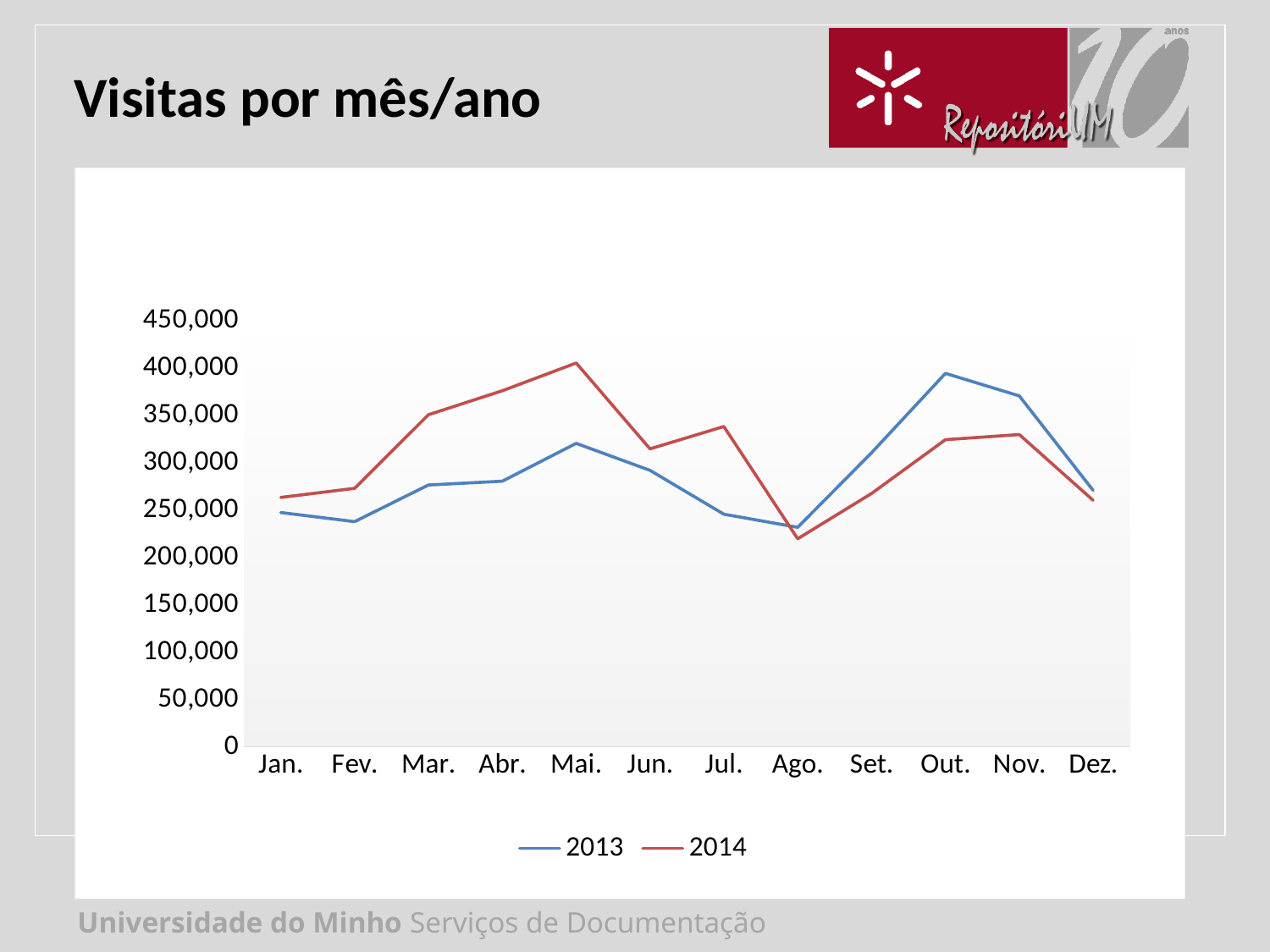
Does the 2013 series rise or fall from Jul. to Out.? rise Is the value for 2014 in Mai. greater or less than 350,000? greater Which series has the larger value in Mar., 2013 or 2014? 2014 What kind of chart is shown on the slide? line chart Which series has the larger value in Out., 2013 or 2014? 2013 How many series does the legend list? 2 In which month does the 2014 series reach its lowest value? Ago. What is the title of the chart? Visitas por mês/ano In which month does the 2013 series reach its highest value? Out. Is the value for 2013 in Fev. greater or less than 250,000? less In which month does the 2014 series reach its highest value? Mai. How many months are plotted along the x axis? 12